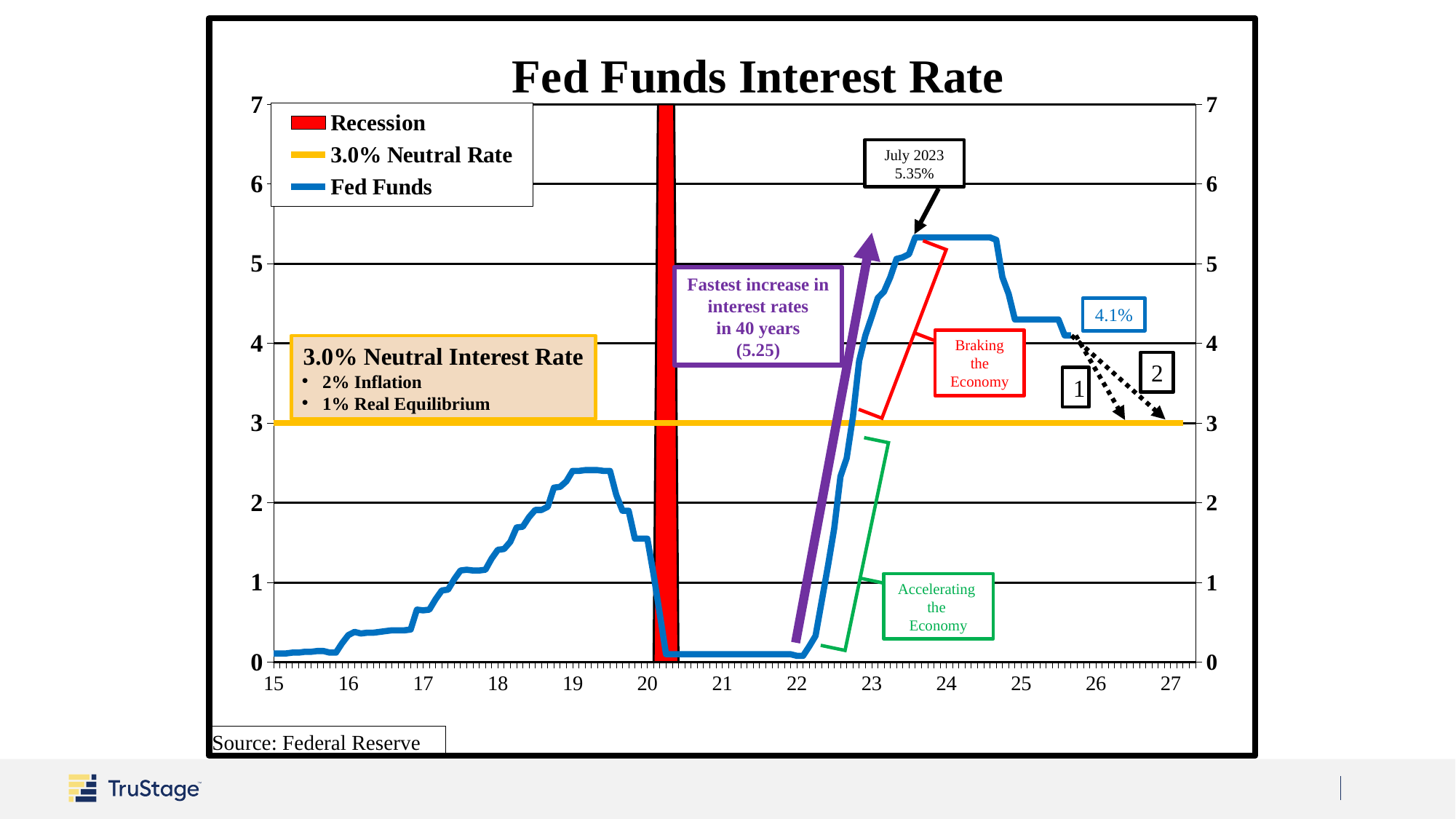
Is the Fed Funds rate during 2021 greater or less than 1? less What kind of chart is shown on the slide? line chart Does the Fed Funds rate rise or fall between 2022 and 2023? rise How many entries does the chart's legend list? 3 Is the Fed Funds rate at the start of 2024 greater or less than 5? greater What value is the neutral interest rate line drawn at? 3.0% Which is higher: the Fed Funds peak around 2019 or the peak around 2023-2024? the peak around 2023-2024 What was the Fed Funds rate in July 2023, according to the annotation? 5.35% How much higher is the July 2023 Fed Funds rate (5.35%) than the 3.0% neutral rate? 2.35 percentage points What is the title of the chart? Fed Funds Interest Rate What is the most recent Fed Funds rate labeled on the chart? 4.1% What is the size of the increase in interest rates described as the fastest in 40 years? 5.25